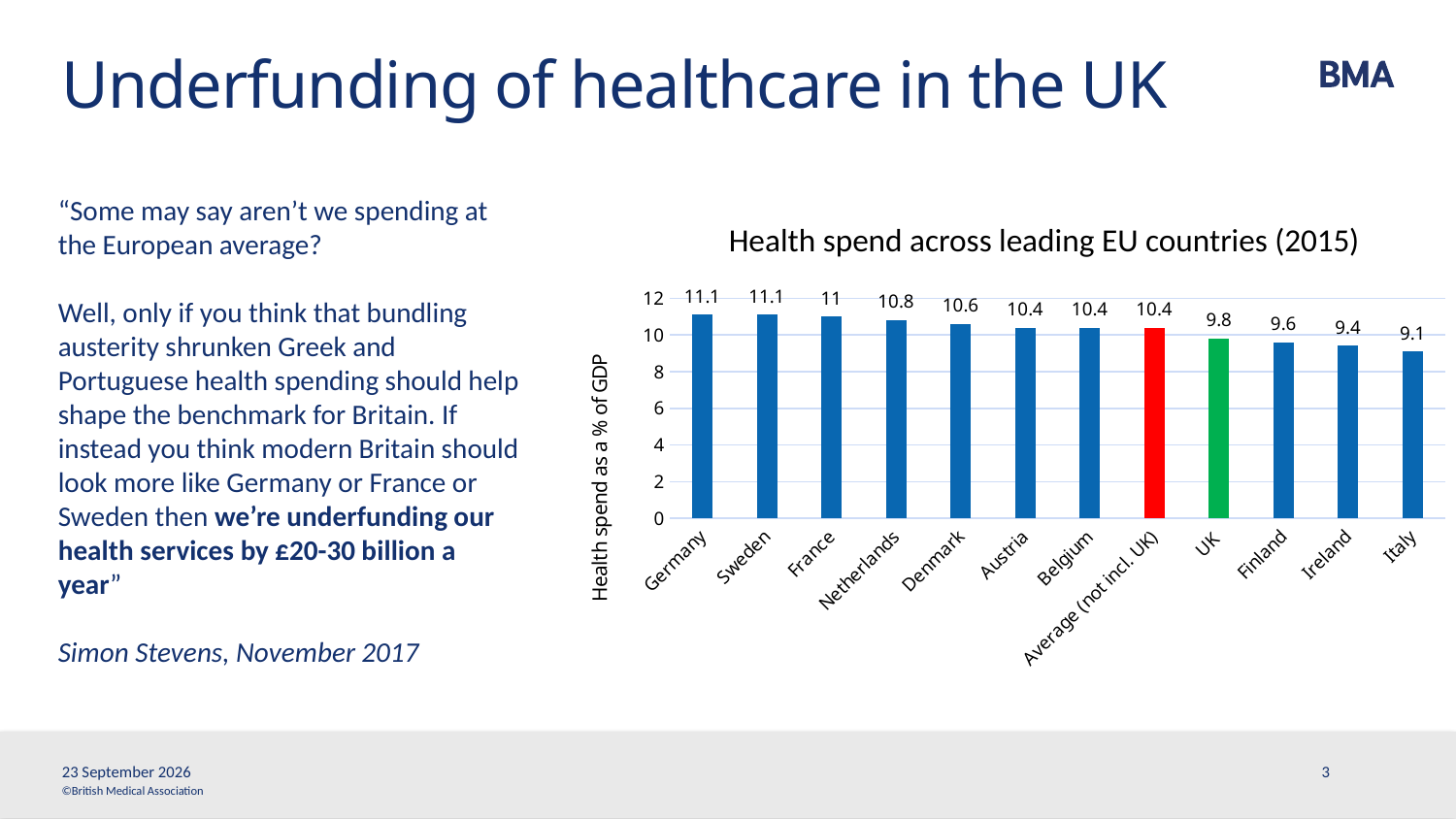
Which country has the lowest health spend as a % of GDP? Italy What is the difference between the Average (not incl. UK) and the UK value? 0.6 How many categories are shown on the x axis? 12 What is the title of the chart? Health spend across leading EU countries (2015) What is the value shown for Netherlands? 10.8 What is the difference between the value for Germany and the value for the UK? 1.3 What is the health spend as a % of GDP for the UK? 9.8 Do the values rise or fall from left to right along the x axis? Fall What is the value shown for Average (not incl. UK)? 10.4 Which has a higher value, France or Finland? France What kind of chart is shown on the slide? Bar chart Is the value for Denmark greater or less than 10? greater